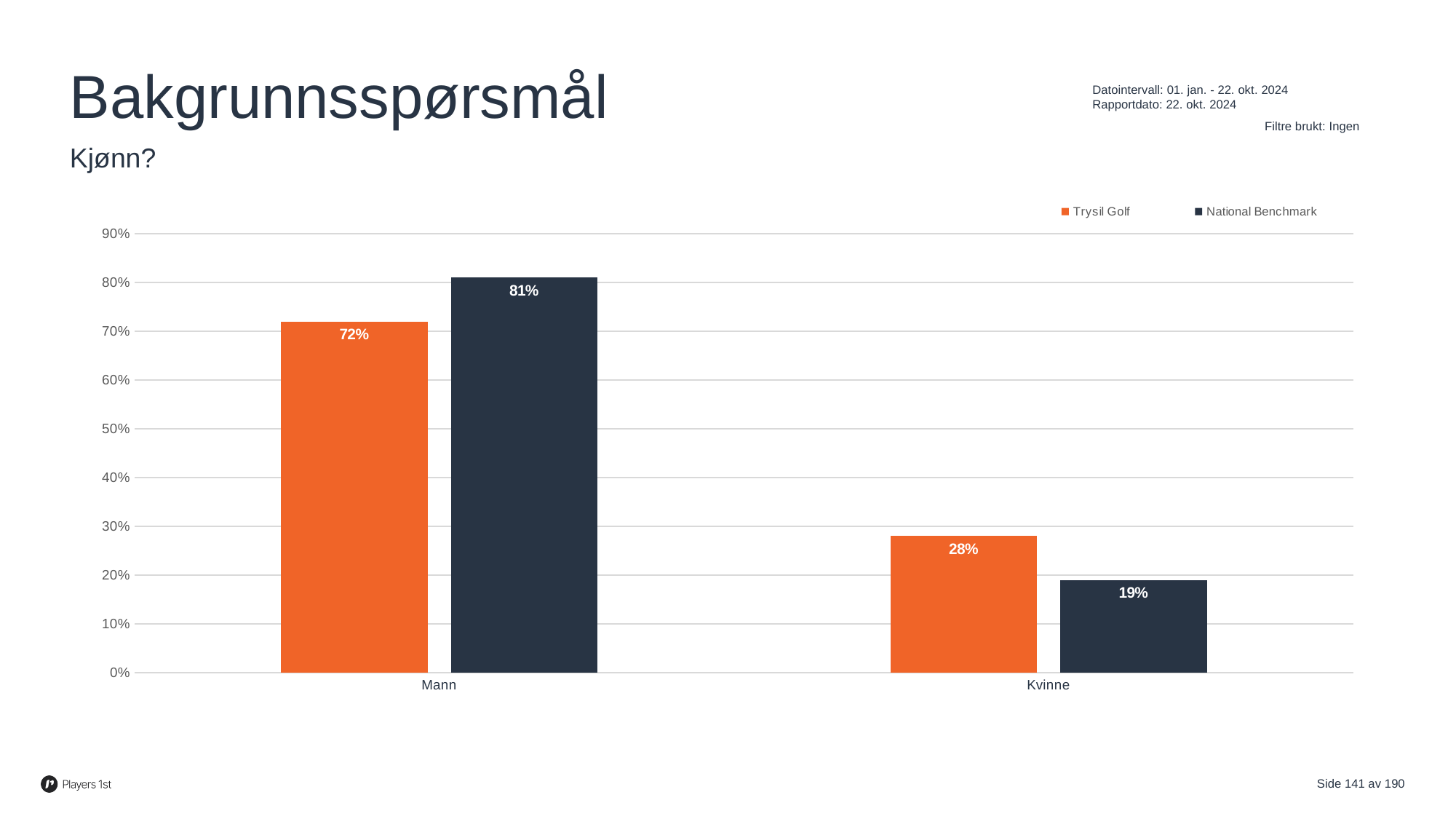
Which category has the lowest value for National Benchmark? Kvinne What is the value for Trysil Golf in the Mann category? 72% Which is larger for Kvinne: Trysil Golf or National Benchmark? Trysil Golf What is the difference between the National Benchmark and Trysil Golf values for Mann? 9% What is the value for National Benchmark in the Mann category? 81% What is the difference between the Trysil Golf and National Benchmark values for Kvinne? 9% What is the value for National Benchmark in the Kvinne category? 19% Which category has the highest value for Trysil Golf? Mann How many series does the legend list? 2 What kind of chart is shown on the slide? Bar chart What is the value for Trysil Golf in the Kvinne category? 28% How many categories are shown on the x axis? 2